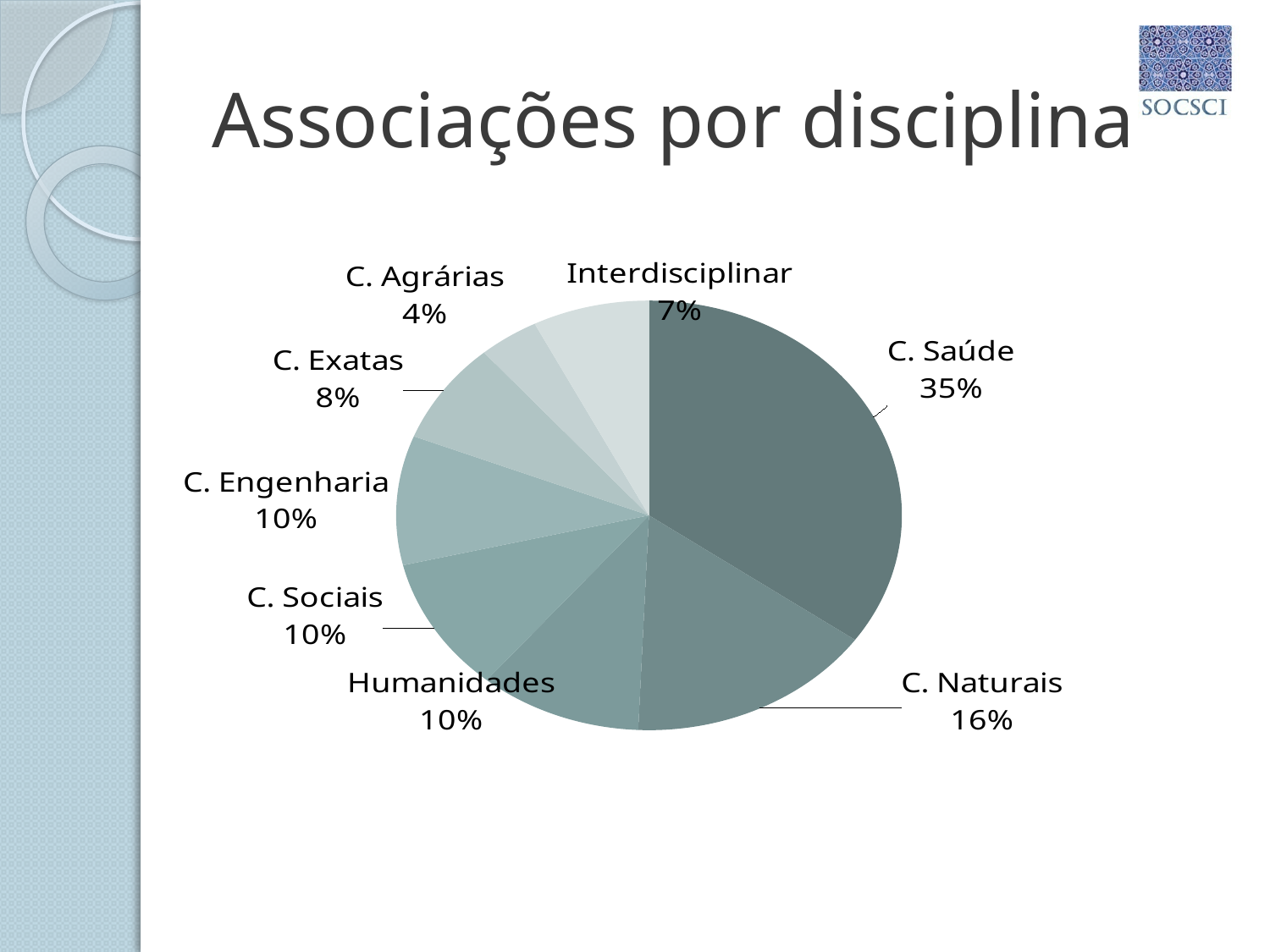
Which category has the smallest slice of the pie? C. Agrárias What is the value shown for Interdisciplinar? 7% How many categories are shown in the pie chart? 8 What is the title of the chart? Associações por disciplina What is the difference between the shares of C. Exatas and C. Agrárias? 4% Which is larger, the share for C. Exatas or the share for Interdisciplinar? C. Exatas What is the difference between the shares of C. Saúde and C. Naturais? 19% What share of the pie does C. Saúde represent? 35% What is the value shown for C. Naturais? 16% What is the value shown for C. Exatas? 8% Which category has the largest slice of the pie? C. Saúde What kind of chart is shown on the slide? pie chart